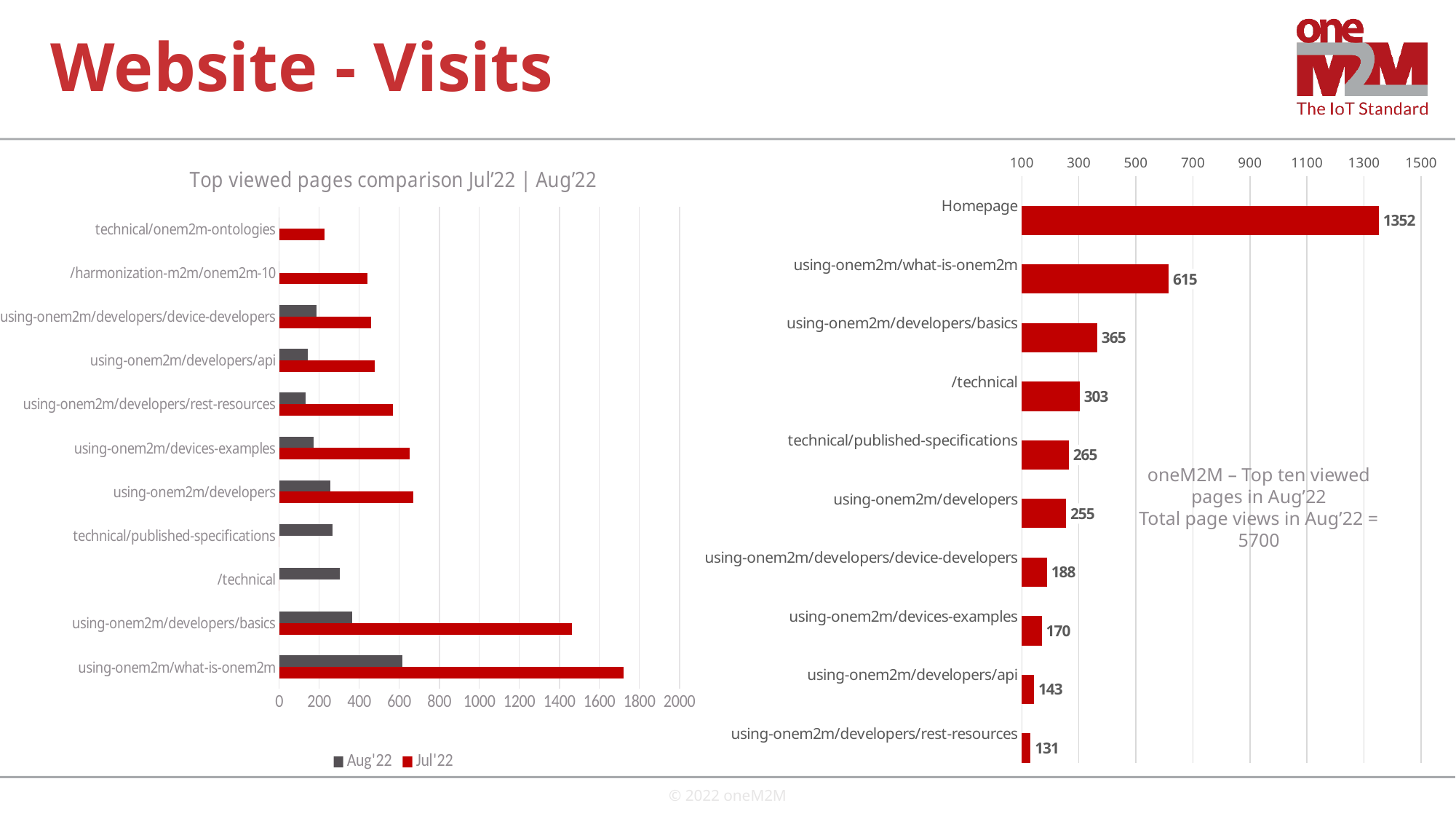
In the right chart (Top ten viewed pages in Aug'22), what is the value for Homepage? 1352 In the right chart (Top ten viewed pages in Aug'22), which page has the lowest value? using-onem2m/developers/rest-resources What kind of chart is the chart on the right titled 'oneM2M – Top ten viewed pages in Aug'22'? bar chart In the right chart (Top ten viewed pages in Aug'22), how many pages are shown? 10 In the right chart (Top ten viewed pages in Aug'22), what is the value for using-onem2m/developers/basics? 365 In the right chart (Top ten viewed pages in Aug'22), what is the difference between Homepage and using-onem2m/what-is-onem2m? 737 In the left chart 'Top viewed pages comparison Jul'22 | Aug'22', which series has the larger value for using-onem2m/developers/basics, Aug'22 or Jul'22? Jul'22 In the left chart 'Top viewed pages comparison Jul'22 | Aug'22', is the Jul'22 value for using-onem2m/what-is-onem2m greater or less than 1600? greater In the right chart (Top ten viewed pages in Aug'22), which is larger: /technical or technical/published-specifications? /technical In the left chart 'Top viewed pages comparison Jul'22 | Aug'22', how many series does the legend list? 2 In the right chart, what total page views in Aug'22 does the text on the chart state? 5700 In the left chart 'Top viewed pages comparison Jul'22 | Aug'22', how many pages are listed on the vertical axis? 11